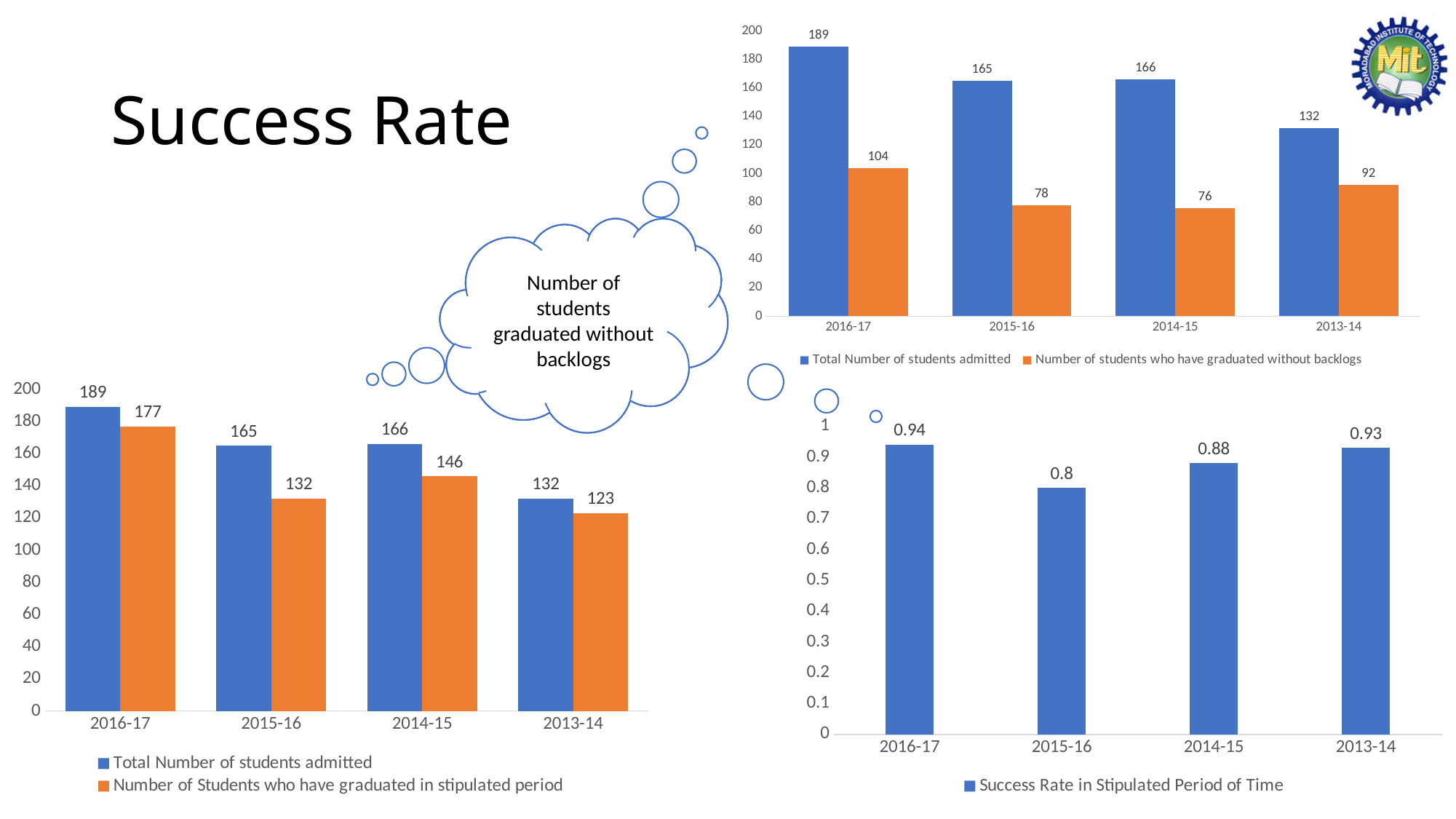
In the top-right chart, how many series does the legend list? 2 In the bottom-left chart, what is the difference between the Total Number of students admitted and the Number of Students who have graduated in stipulated period for 2015-16? 33 In the top-right chart, which year has the highest Number of students who have graduated without backlogs? 2016-17 In the bottom-left chart, which year has the lowest Number of Students who have graduated in stipulated period? 2013-14 In the top-right chart, what is the difference between the Total Number of students admitted and the Number of students who have graduated without backlogs for 2016-17? 85 In the bottom-right chart, which year has the highest Success Rate in Stipulated Period of Time? 2016-17 What kind of chart is the bottom-right chart? bar chart In the top-right chart, what is the Number of students who have graduated without backlogs for 2014-15? 76 In the bottom-left chart, what is the Number of Students who have graduated in stipulated period for 2016-17? 177 In the bottom-right chart, is the Success Rate for 2014-15 larger or smaller than for 2013-14? smaller In the bottom-right chart, what is the Success Rate in Stipulated Period of Time for 2015-16? 0.8 In the bottom-left chart, what is the Total Number of students admitted for 2013-14? 132